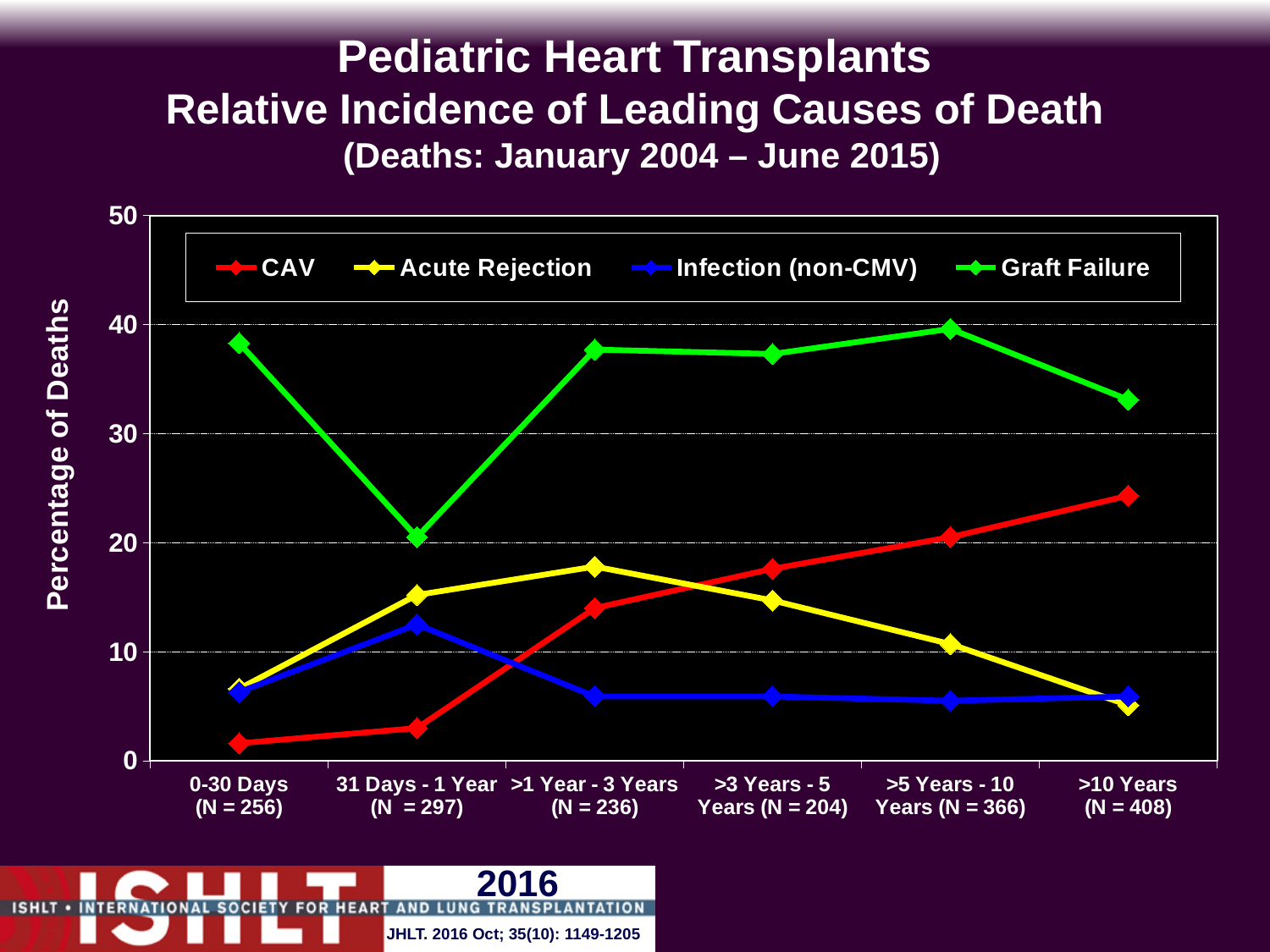
In which time period is the CAV value highest? >10 Years How many time-period categories are shown on the x axis? 6 Is the Infection (non-CMV) value for >1 Year - 3 Years greater or less than 10? less In which time period is the Graft Failure value lowest? 31 Days - 1 Year Is the CAV value for >10 Years greater or less than 20? greater What is the y-axis title of the chart? Percentage of Deaths Does the CAV line rise or fall across the time periods from 0-30 Days to >10 Years? rises At 31 Days - 1 Year, which is larger: Acute Rejection or CAV? Acute Rejection How many series does the legend list? 4 Is the Graft Failure value for 0-30 Days greater or less than 30? greater In which time period is the Acute Rejection value highest? >1 Year - 3 Years What kind of chart is shown on the slide? line chart